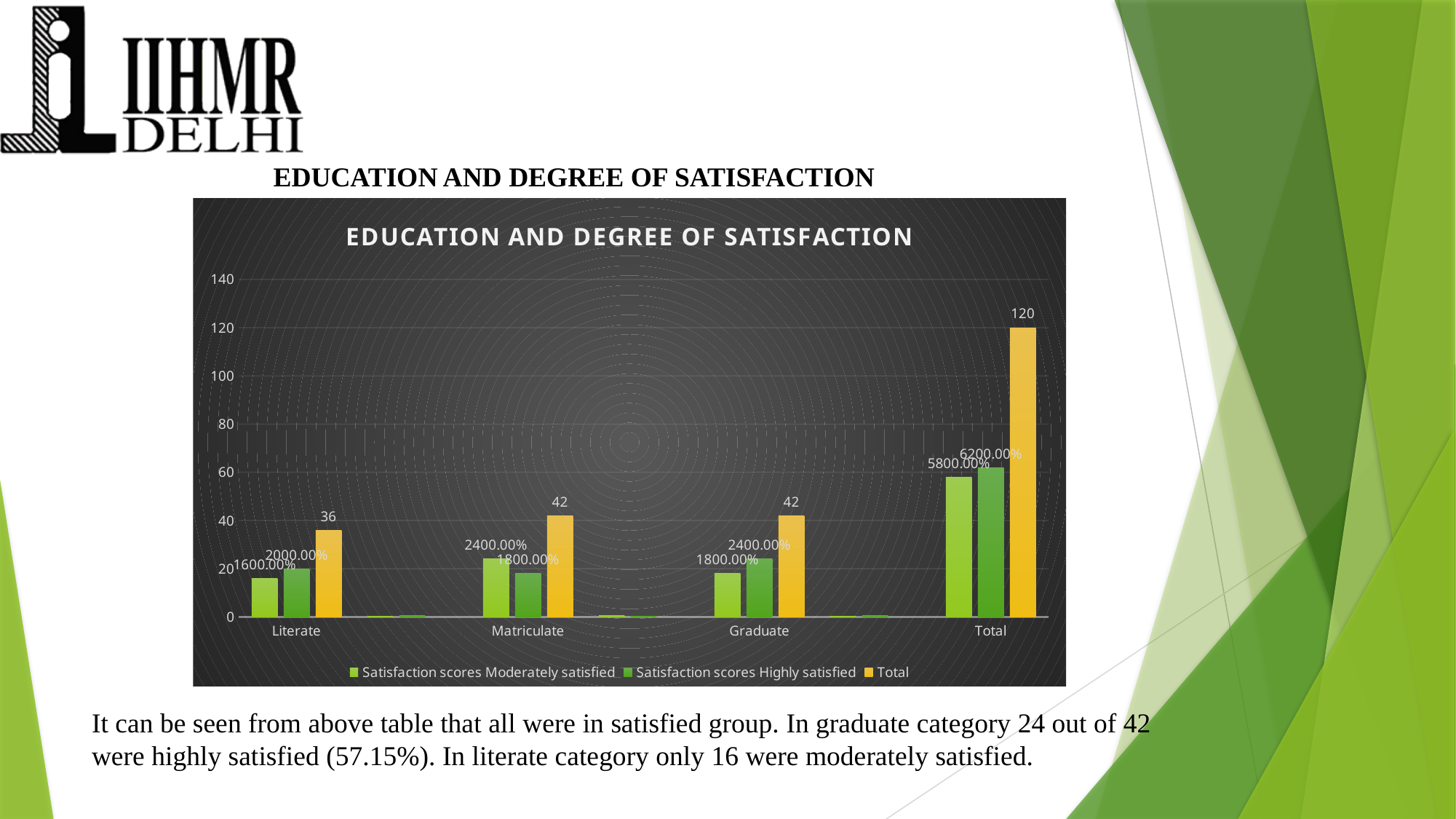
How many series does the legend list? 3 What is the value of the Total series for the Total category? 120 What is the value of the Total series for the Literate category? 36 What data label is shown for Satisfaction scores Highly satisfied in the Graduate category? 2400.00% Is the Total series value for the Total category greater or less than 100? greater What kind of chart is shown on the slide? bar chart What is the title of the chart? EDUCATION AND DEGREE OF SATISFACTION Which category has the lowest value in the Total series? Literate What is the difference between the Total series values for Matriculate and Literate? 6 How many categories are shown on the x axis? 4 Which category has the highest value in the Total series? Total What data label is shown for Satisfaction scores Moderately satisfied in the Matriculate category? 2400.00%